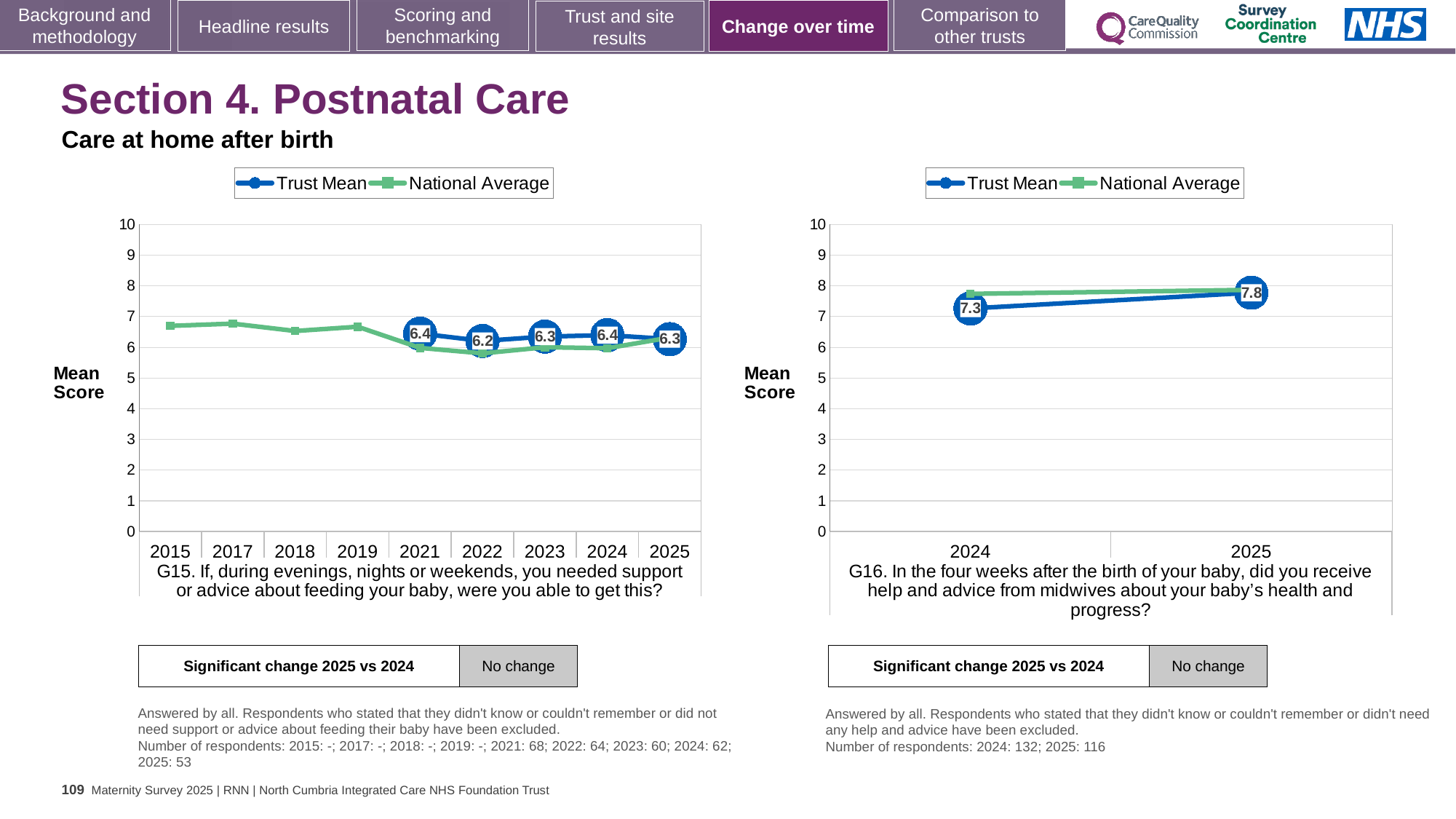
In the G16 chart on the right, what is the Trust Mean for 2024? 7.3 In the G15 chart on the left, which year has the lowest labelled Trust Mean? 2022 In the G15 chart on the left, is the National Average for 2015 greater or less than 6? greater In the G16 chart on the right, what is the Trust Mean for 2025? 7.8 How many years are shown on the x axis of the G15 chart on the left? 9 How many series does the legend of the G16 chart on the right list? 2 In the G15 chart on the left, what is the Trust Mean for 2025? 6.3 In the G15 chart on the left, what is the difference between the Trust Mean in 2024 and in 2025? 0.1 In the G15 chart on the left, what is the Trust Mean for 2022? 6.2 What type of chart is the G16 chart on the right? line chart In the G16 chart on the right, by how much did the Trust Mean change from 2024 to 2025? 0.5 In the G16 chart on the right, did the Trust Mean rise or fall from 2024 to 2025? rise